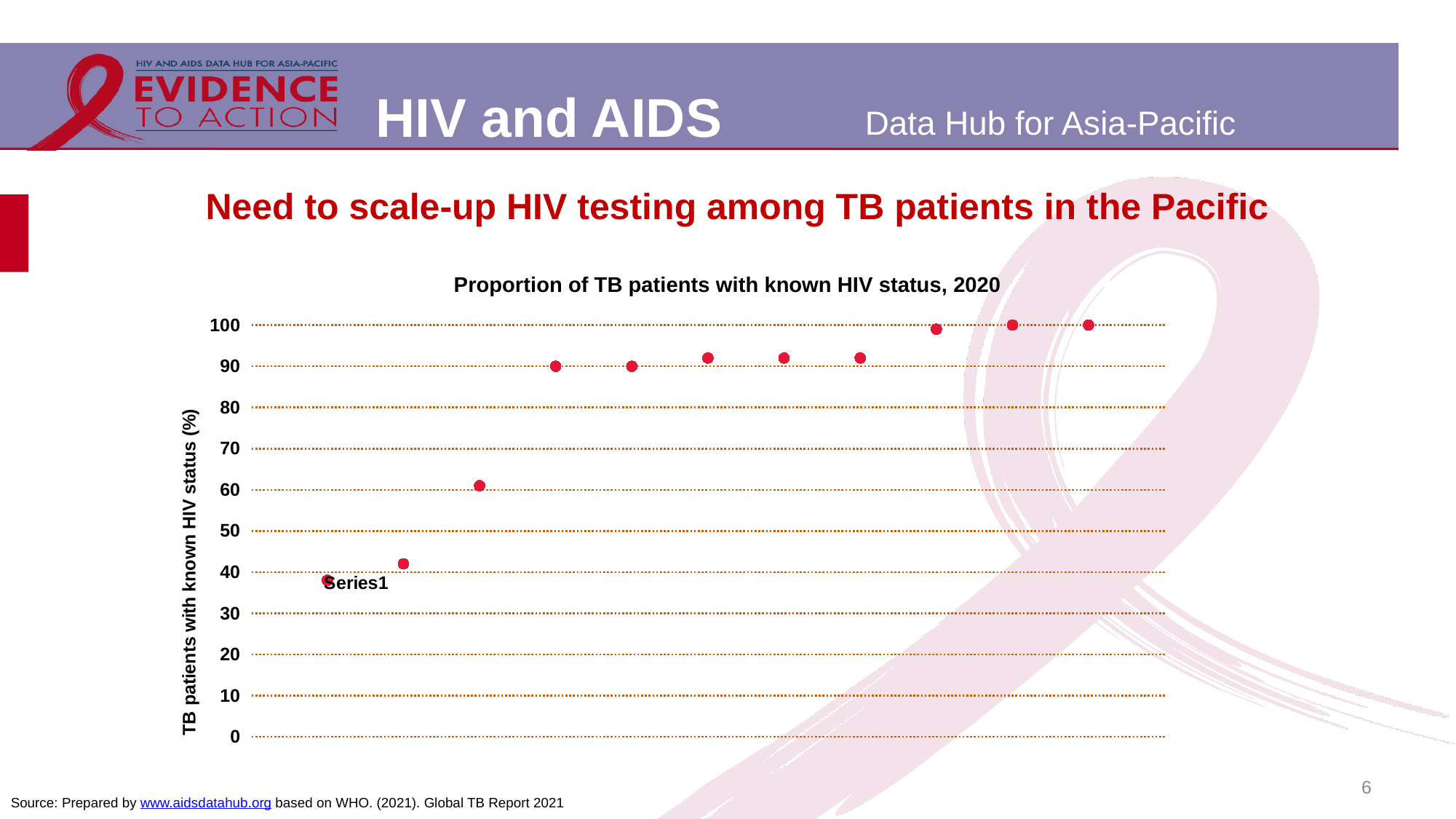
How many plotted points have values above 80? 8 Is the rightmost point higher or lower than the leftmost point? Higher How many data points are plotted on the chart? 11 What is the title of the chart? Proportion of TB patients with known HIV status, 2020 Is the value of the lowest plotted point greater or less than 50? less What is the label on the vertical axis of the chart? TB patients with known HIV status (%) What is the highest value shown on the vertical axis? 100 How many plotted points have values below 70? 3 Is the value of the fourth point from the left greater or less than 80? greater What kind of chart is shown on the slide? Scatter (dot) chart Do the plotted values rise or fall from left to right along the x axis? Rise Is the value of the third point from the left greater or less than 50? greater